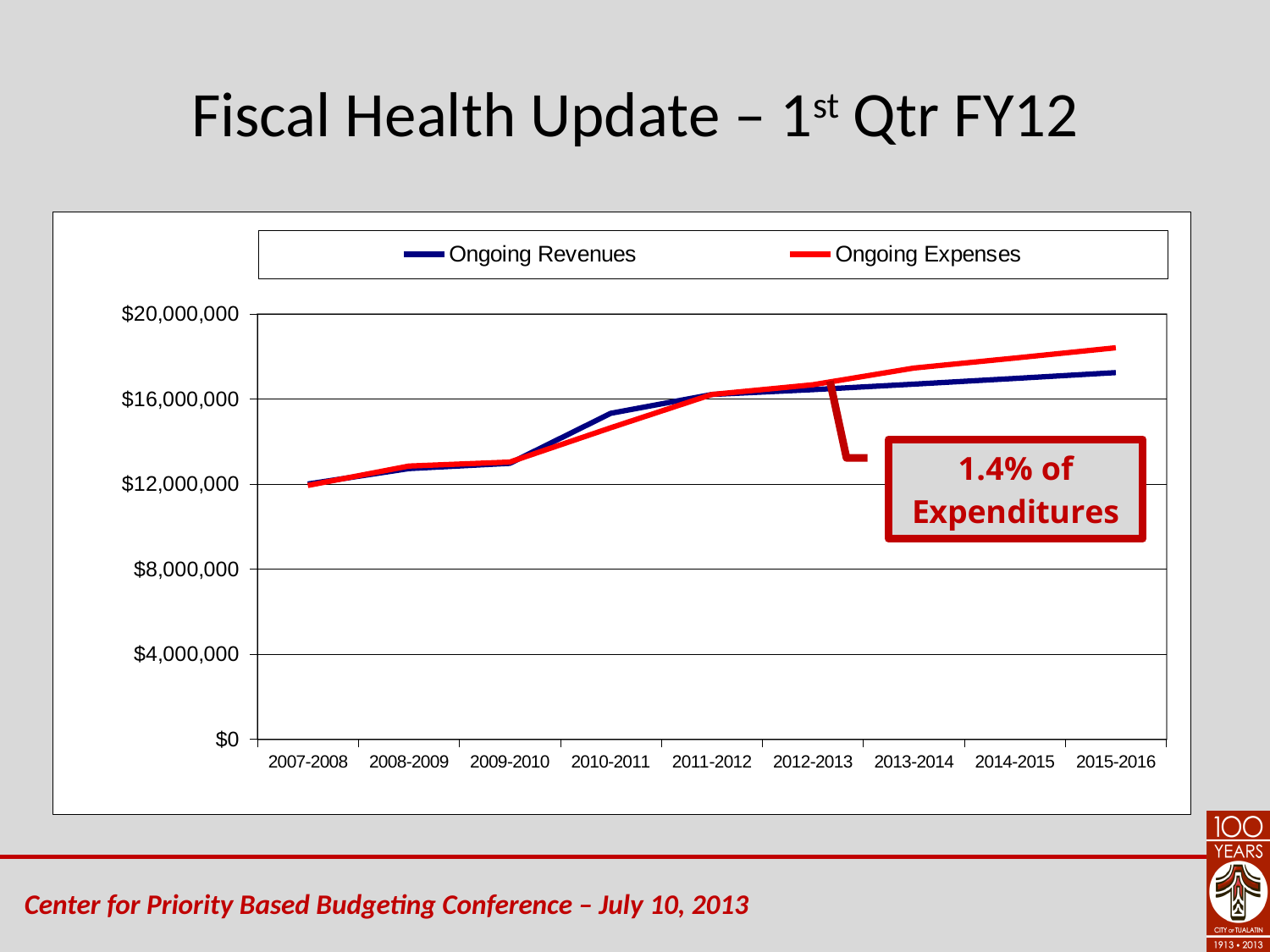
Is the value for Ongoing Revenues in 2010-2011 greater or less than $16,000,000? less What does the red callout box on the chart say? 1.4% of Expenditures Is the value for Ongoing Expenses in 2015-2016 greater or less than $16,000,000? greater Is the value for Ongoing Revenues in 2015-2016 greater or less than $16,000,000? greater Which colour is used for the Ongoing Revenues line? blue How many fiscal years are shown along the x axis? 9 In 2015-2016, which series has the higher value, Ongoing Revenues or Ongoing Expenses? Ongoing Expenses Do the Ongoing Expenses values rise or fall from 2007-2008 to 2015-2016? rise How many series does the legend list? 2 What kind of chart is shown on the slide? line chart